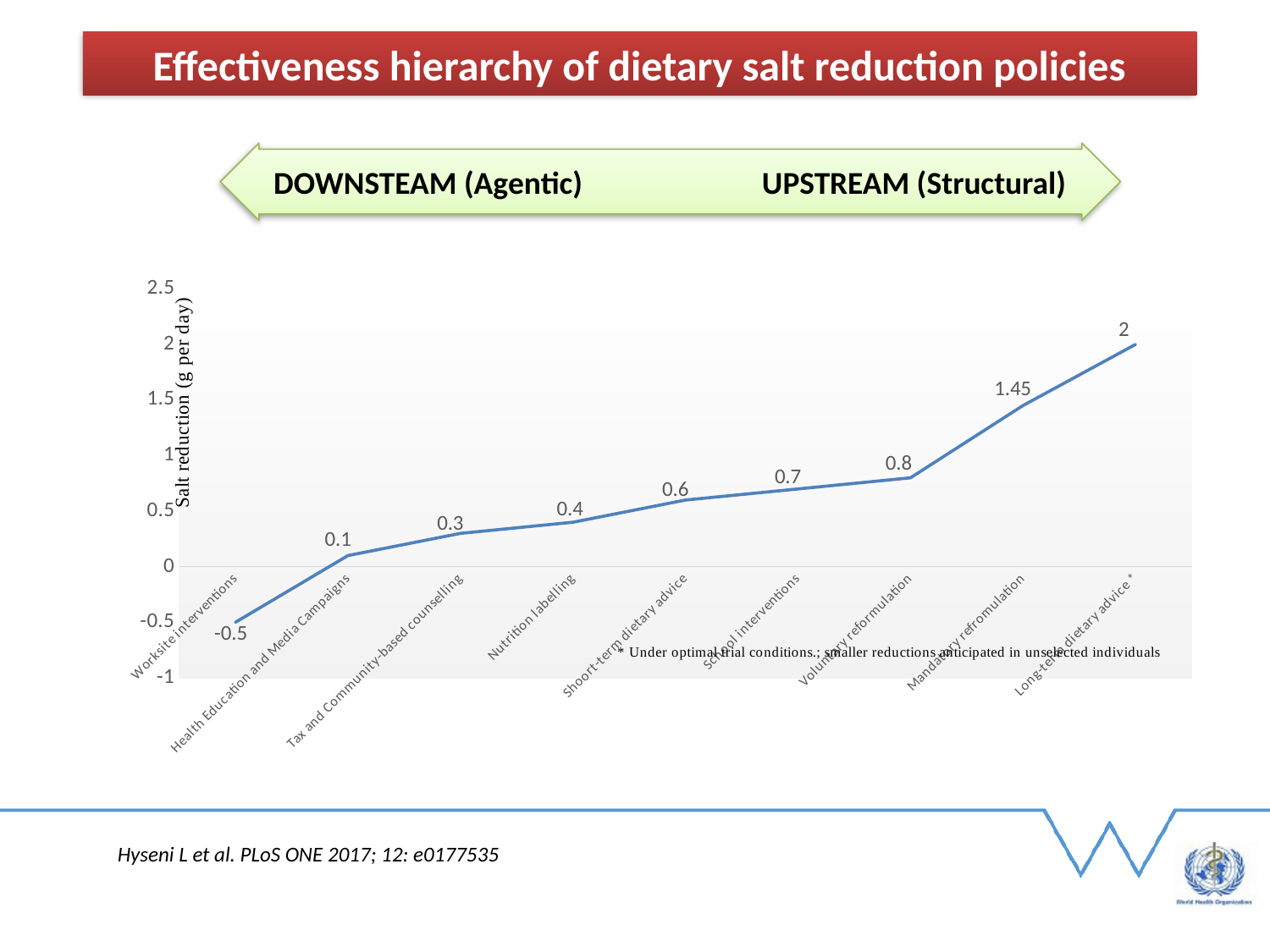
How many policies are plotted on the chart? 9 What is the difference between the salt reduction values for Mandatory reformulation and Nutrition labelling? 1.05 Which policy has the highest salt reduction value? Long-term dietary advice * What is the salt reduction value for Nutrition labelling? 0.4 Do the salt reduction values rise or fall from left to right along the x axis? Rise What is the salt reduction value for Health Education and Media Campaigns? 0.1 What is the title of the vertical axis? Salt reduction (g per day) What is the salt reduction value for Mandatory reformulation? 1.45 What is the salt reduction value for Worksite interventions? -0.5 Which has a larger salt reduction value, Tax and Community-based counselling or Shoort-term dietary advice? Shoort-term dietary advice Which policy has the lowest salt reduction value? Worksite interventions What kind of chart is shown on the slide? Line chart